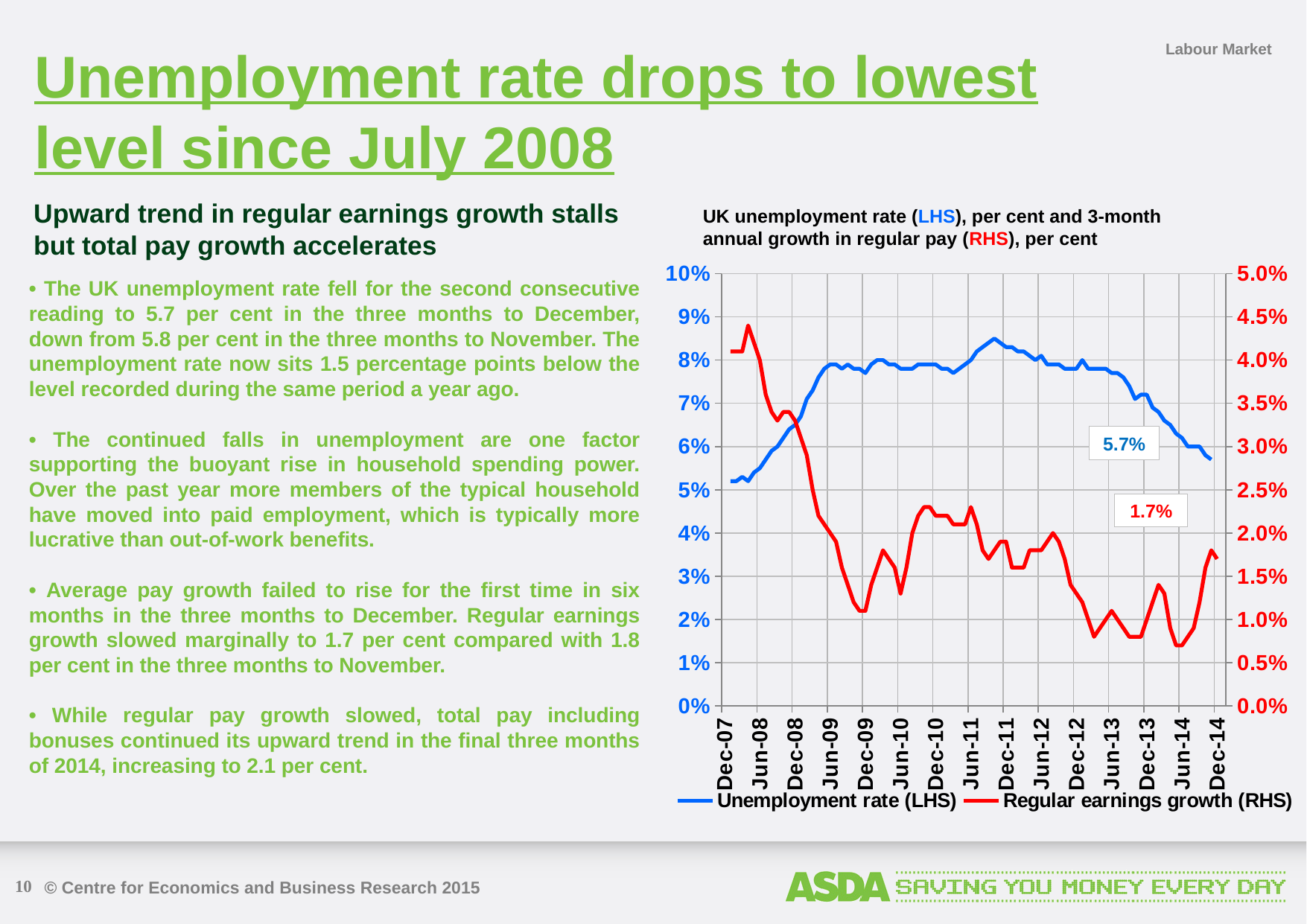
Does the unemployment rate rise or fall between Dec-11 and Dec-14? Fall Is regular earnings growth at Dec-09 greater or less than 2.0%? less Is the unemployment rate at Dec-07 greater or less than 6%? less What is the labelled value of regular earnings growth at Dec-14? 1.7% Does the unemployment rate rise or fall between Dec-07 and Dec-09? Rise How many series does the chart legend list? 2 Is regular earnings growth at Dec-07 greater or less than 3.5%? greater Which axis is the unemployment rate plotted against, according to the legend? LHS (left-hand side) What colour is the line for regular earnings growth? Red What kind of chart is shown on the slide? Line chart What is the labelled value of the unemployment rate at Dec-14? 5.7%